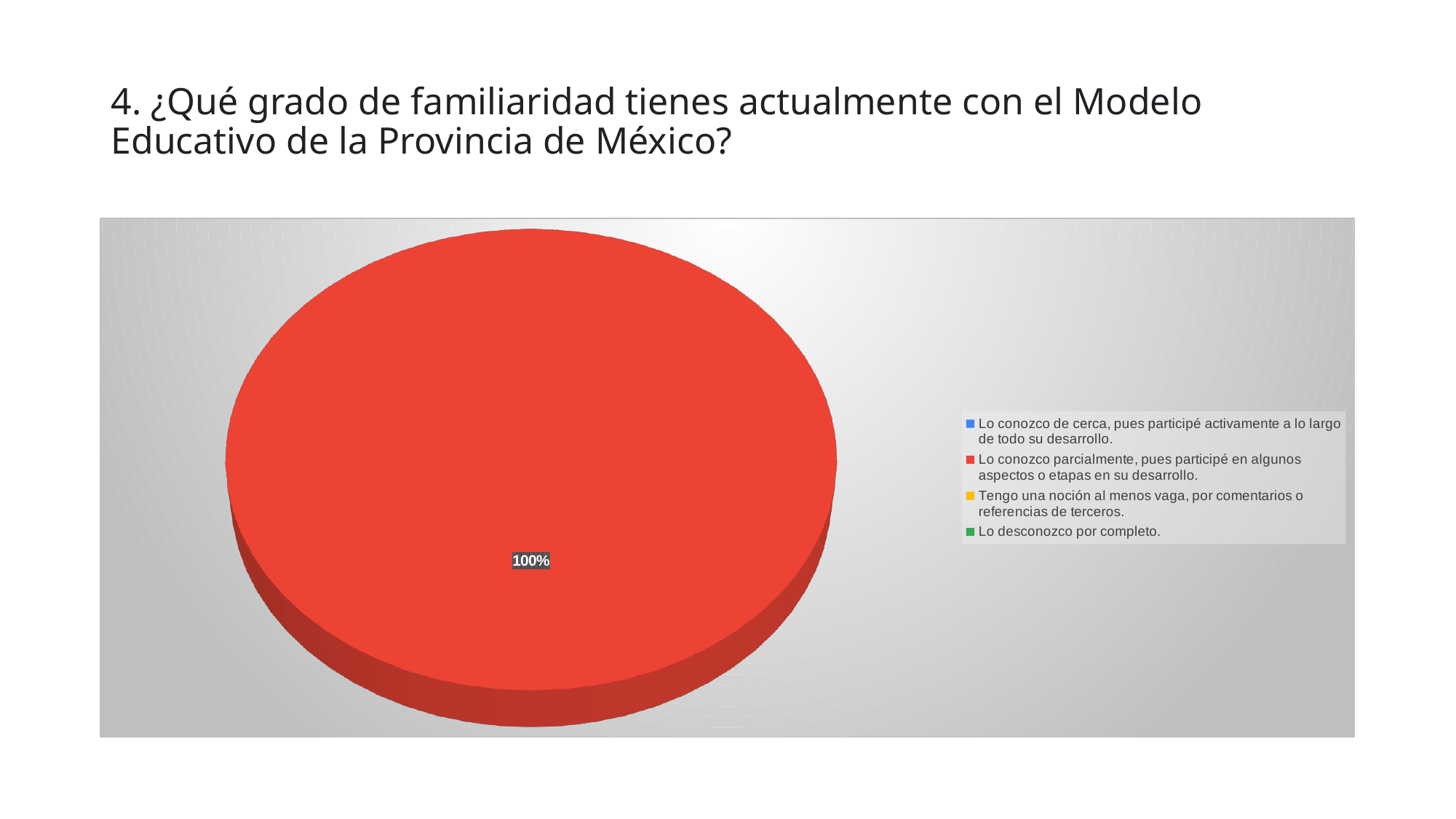
What colour is the slice that makes up the whole pie? Red What kind of chart is shown on the slide? Pie chart Which colour does the legend assign to 'Lo desconozco por completo.'? Green Which category has the largest share of the pie? Lo conozco parcialmente, pues participé en algunos aspectos o etapas en su desarrollo. Which legend category does the red slice that fills the entire pie correspond to? Lo conozco parcialmente, pues participé en algunos aspectos o etapas en su desarrollo. Is the share for 'Lo conozco parcialmente, pues participé en algunos aspectos o etapas en su desarrollo.' greater or less than 50%? greater How many categories does the legend of the pie chart list? 4 Which is larger: the share for 'Lo conozco parcialmente, pues participé en algunos aspectos o etapas en su desarrollo.' or the share for 'Lo desconozco por completo.'? Lo conozco parcialmente, pues participé en algunos aspectos o etapas en su desarrollo. How many slices are visible in the pie chart? 1 What percentage is shown on the data label of the pie chart? 100% What share of the pie does the category 'Lo conozco parcialmente, pues participé en algunos aspectos o etapas en su desarrollo.' take? 100%